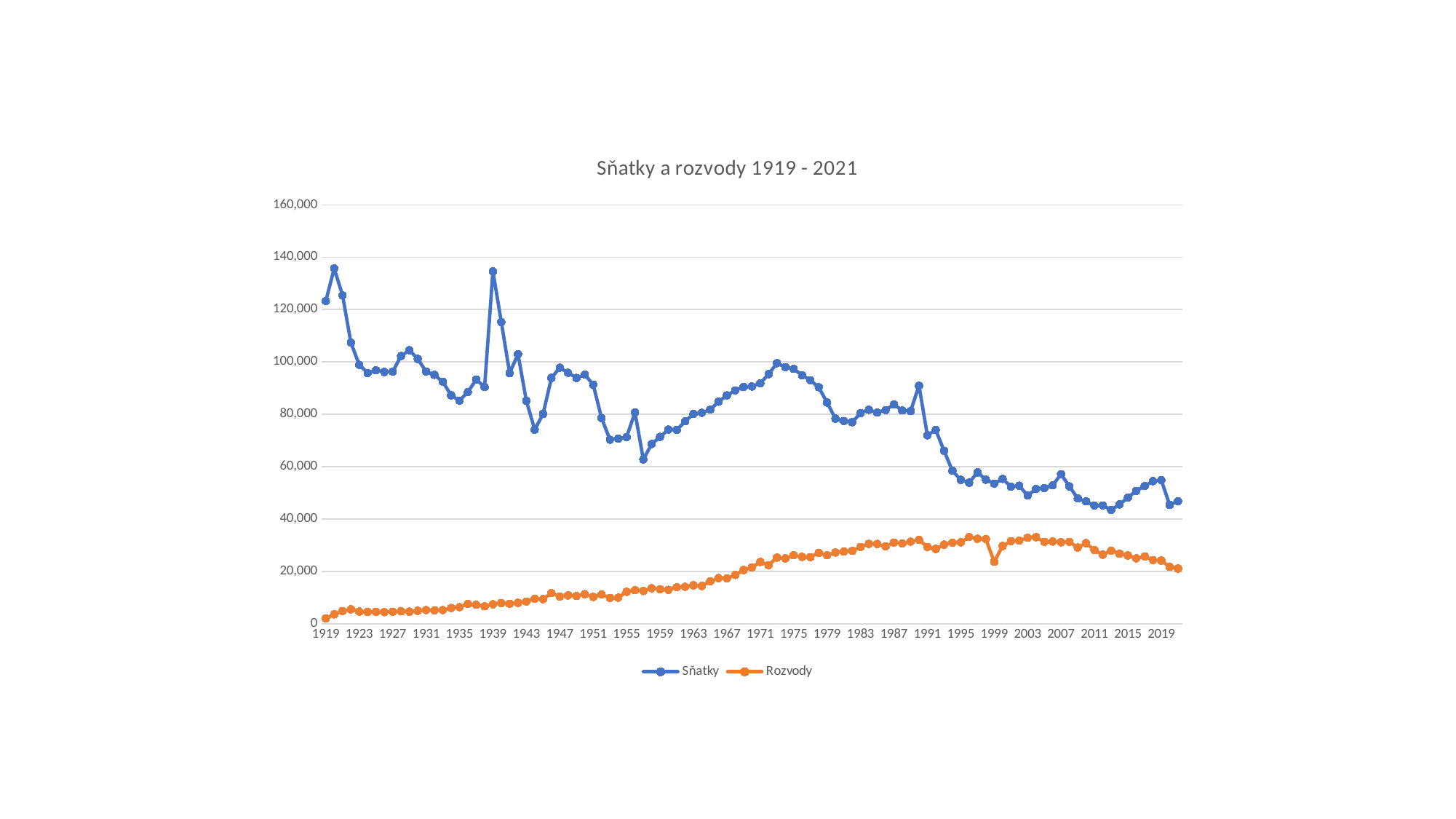
Which series is drawn in orange? Rozvody Is the value for Sňatky in 2013 greater or less than 60,000? less Is the value for Sňatky in 1957 greater or less than 80,000? less What kind of chart is shown on the slide? line chart Is the value for Rozvody in 2021 greater or less than 40,000? less What is the title of the chart? Sňatky a rozvody 1919 - 2021 Which series has the larger value in 1975, Sňatky or Rozvody? Sňatky Do the values for Rozvody generally rise or fall from 1919 to 1975? rise Do the values for Sňatky generally rise or fall from 1991 to 2013? fall How many series does the legend list? 2